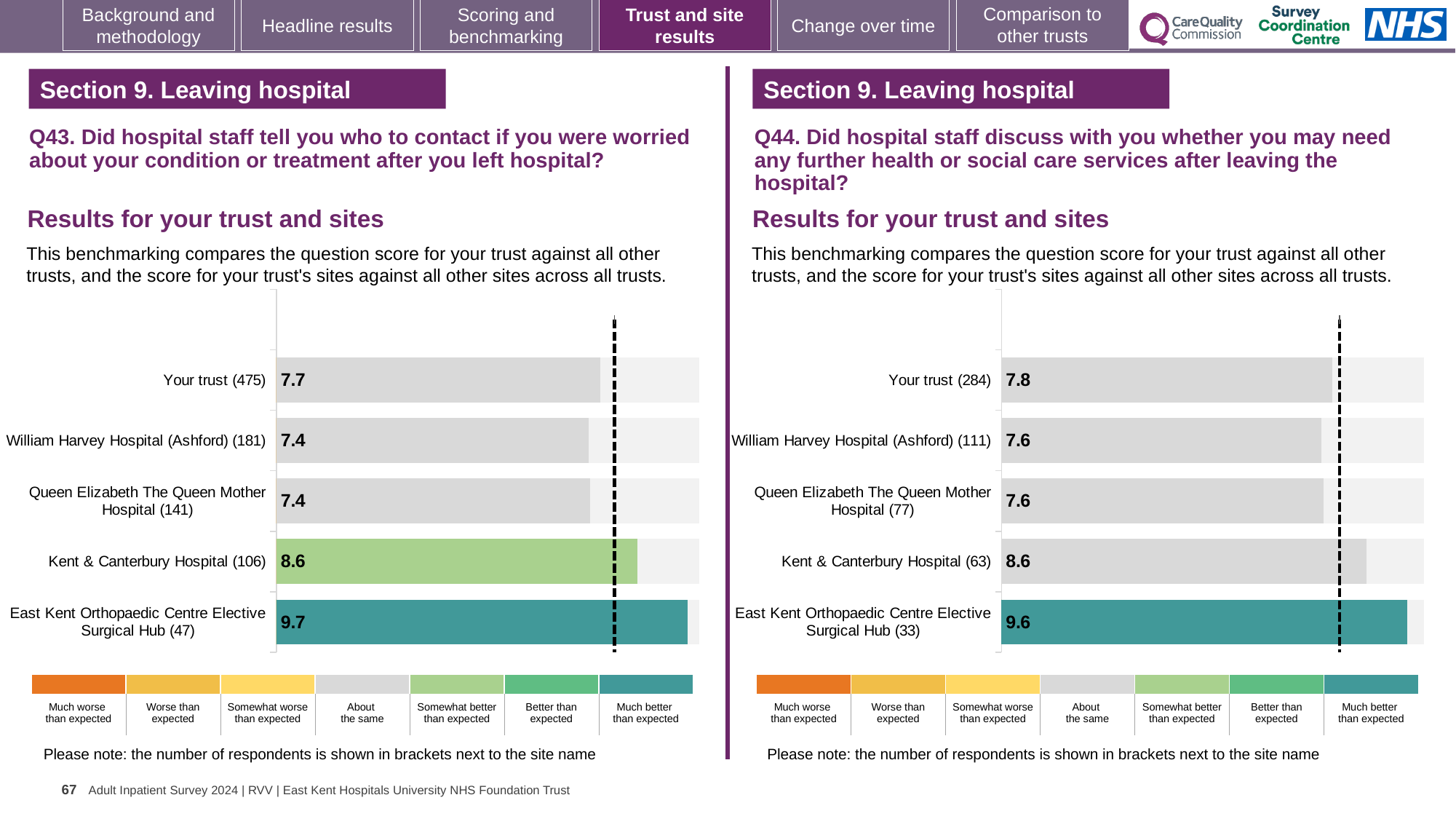
On the Q44 chart (right), how many bars are plotted? 5 On the Q43 chart (left), what category does the colour of the Kent & Canterbury Hospital bar represent according to the legend? Somewhat better than expected On the Q43 chart (left), which site has the highest score? East Kent Orthopaedic Centre Elective Surgical Hub What type of chart is shown on the Q43 chart (left)? Bar chart On the Q43 chart (left), what is the score for Your trust? 7.7 On the Q44 chart (right), what is the score for East Kent Orthopaedic Centre Elective Surgical Hub? 9.6 On the Q43 chart (left), what is the difference between the scores for East Kent Orthopaedic Centre Elective Surgical Hub and Kent & Canterbury Hospital? 1.1 On the Q43 chart (left), how many respondents are shown in brackets for Your trust? 475 On the Q44 chart (right), which site has the highest score? East Kent Orthopaedic Centre Elective Surgical Hub On the Q44 chart (right), what is the difference between the scores for Your trust and William Harvey Hospital (Ashford)? 0.2 On the Q43 chart (left), which has the higher score: Kent & Canterbury Hospital or Your trust? Kent & Canterbury Hospital On the Q44 chart (right), what is the score for Kent & Canterbury Hospital? 8.6